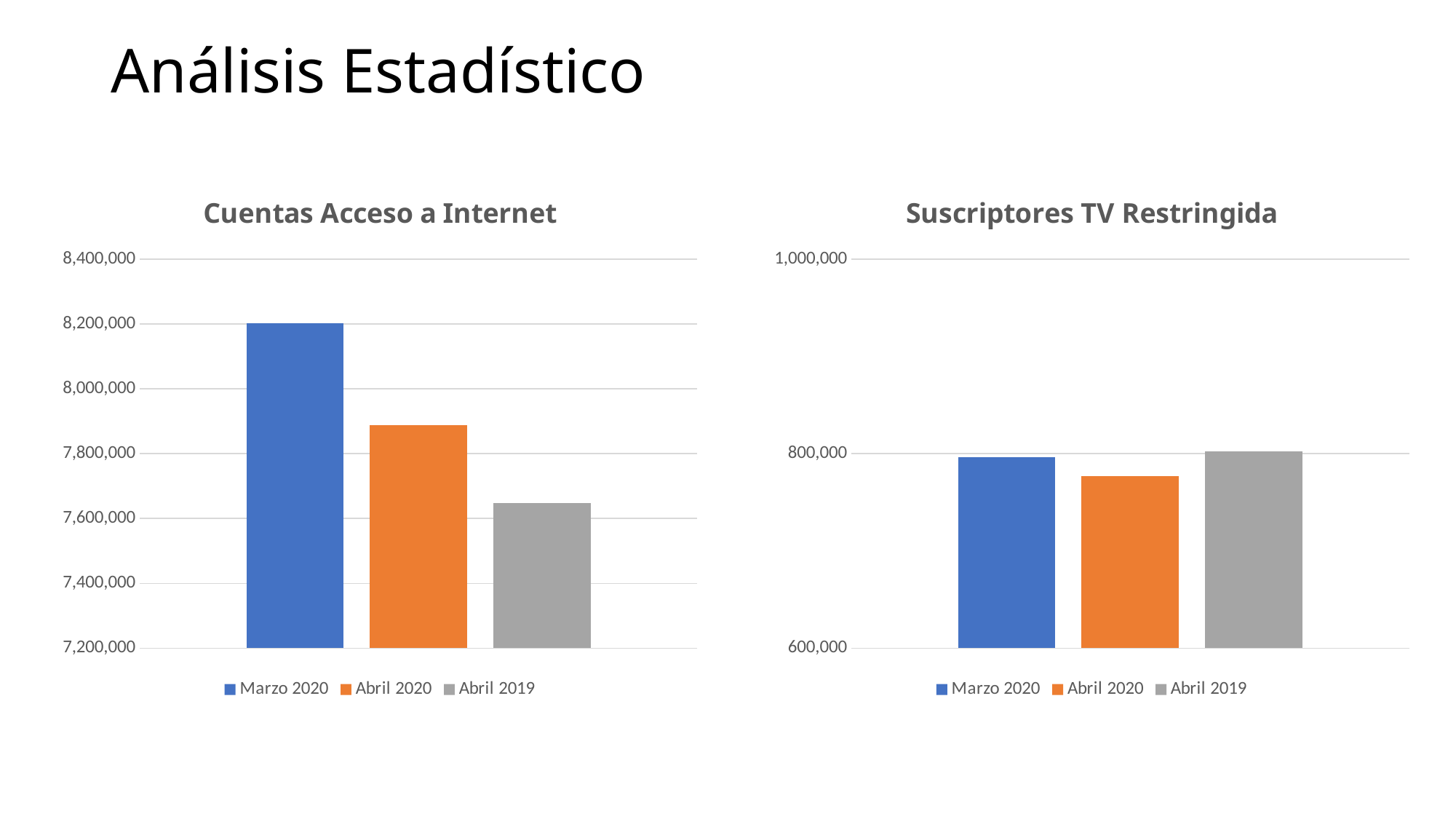
In the 'Cuentas Acceso a Internet' chart, which series has the lowest value? Abril 2019 In the 'Suscriptores TV Restringida' chart, which series has the lowest value? Abril 2020 In the 'Cuentas Acceso a Internet' chart, is the value for Abril 2019 greater or less than 7,800,000? less In the 'Cuentas Acceso a Internet' chart, which is larger, Abril 2020 or Abril 2019? Abril 2020 In the 'Suscriptores TV Restringida' chart, which is larger, Marzo 2020 or Abril 2020? Marzo 2020 In the 'Cuentas Acceso a Internet' chart, what colour is the Abril 2020 bar? Orange In the 'Cuentas Acceso a Internet' chart, is the value for Abril 2020 greater or less than 7,800,000? greater In the 'Cuentas Acceso a Internet' chart, is the value for Marzo 2020 greater or less than 8,000,000? greater How many series does the legend of the 'Suscriptores TV Restringida' chart list? 3 In the 'Cuentas Acceso a Internet' chart, which series has the highest value? Marzo 2020 What kind of chart is the 'Cuentas Acceso a Internet' chart? Bar chart